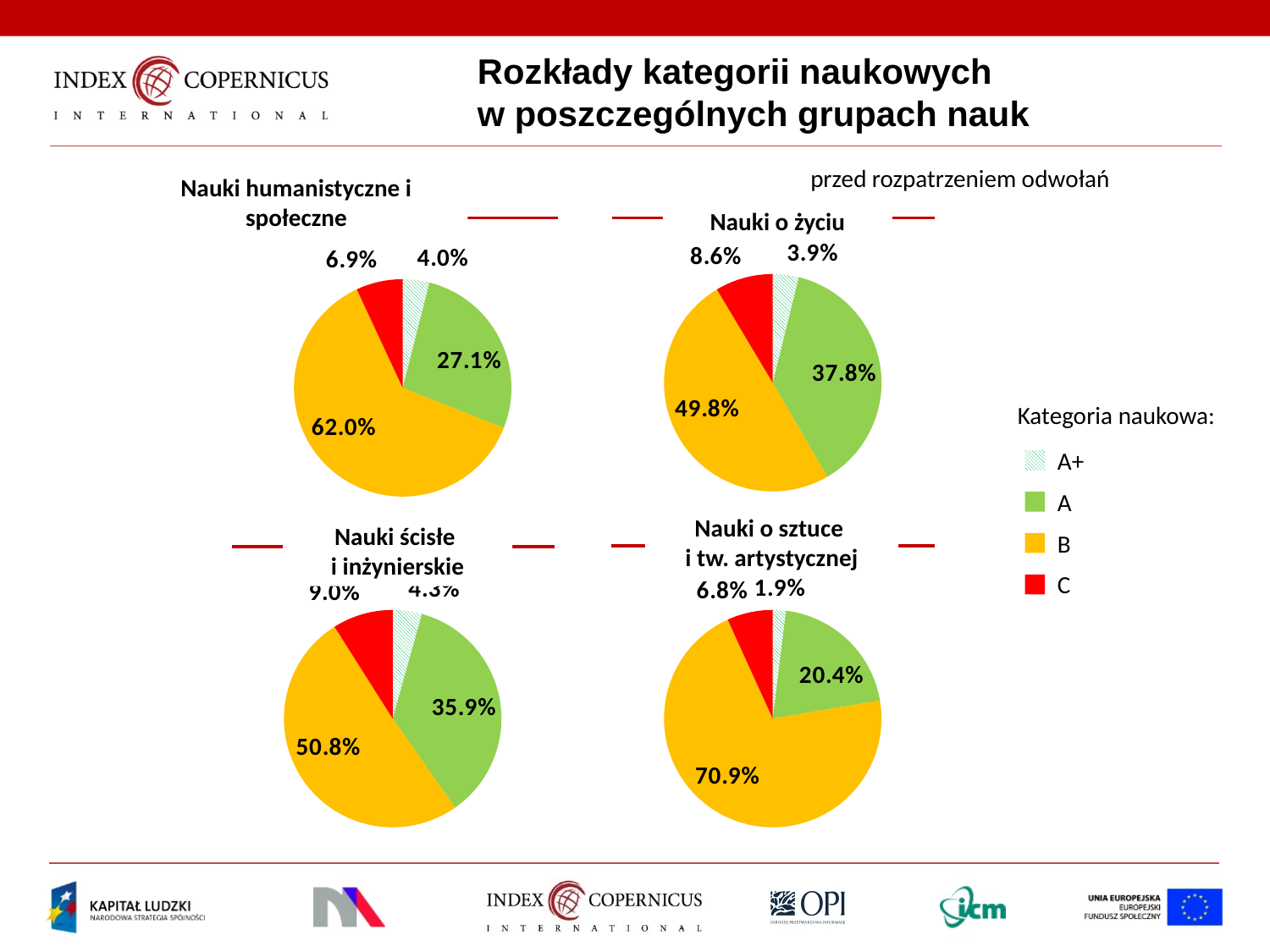
In the 'Nauki humanistyczne i społeczne' pie chart, which category has the smallest share? A+ In the legend, which colour represents category C? Red In the 'Nauki o życiu' pie chart, which category has the largest share? B In the 'Nauki o życiu' pie chart, which is larger: the share of category C or the share of category A+? C What type of chart is used for 'Nauki ścisłe i inżynierskie'? Pie chart In the 'Nauki humanistyczne i społeczne' pie chart, what share does category B have? 62.0% How many pie charts are shown on the slide? 4 In the 'Nauki o sztuce i tw. artystycznej' pie chart, what is the difference between the shares of category B and category A? 50.5% In the 'Nauki o sztuce i tw. artystycznej' pie chart, what share does category A+ have? 1.9% How many categories does the legend 'Kategoria naukowa' list? 4 In the 'Nauki o życiu' pie chart, what share does category A have? 37.8% In the 'Nauki ścisłe i inżynierskie' pie chart, what share does category B have? 50.8%